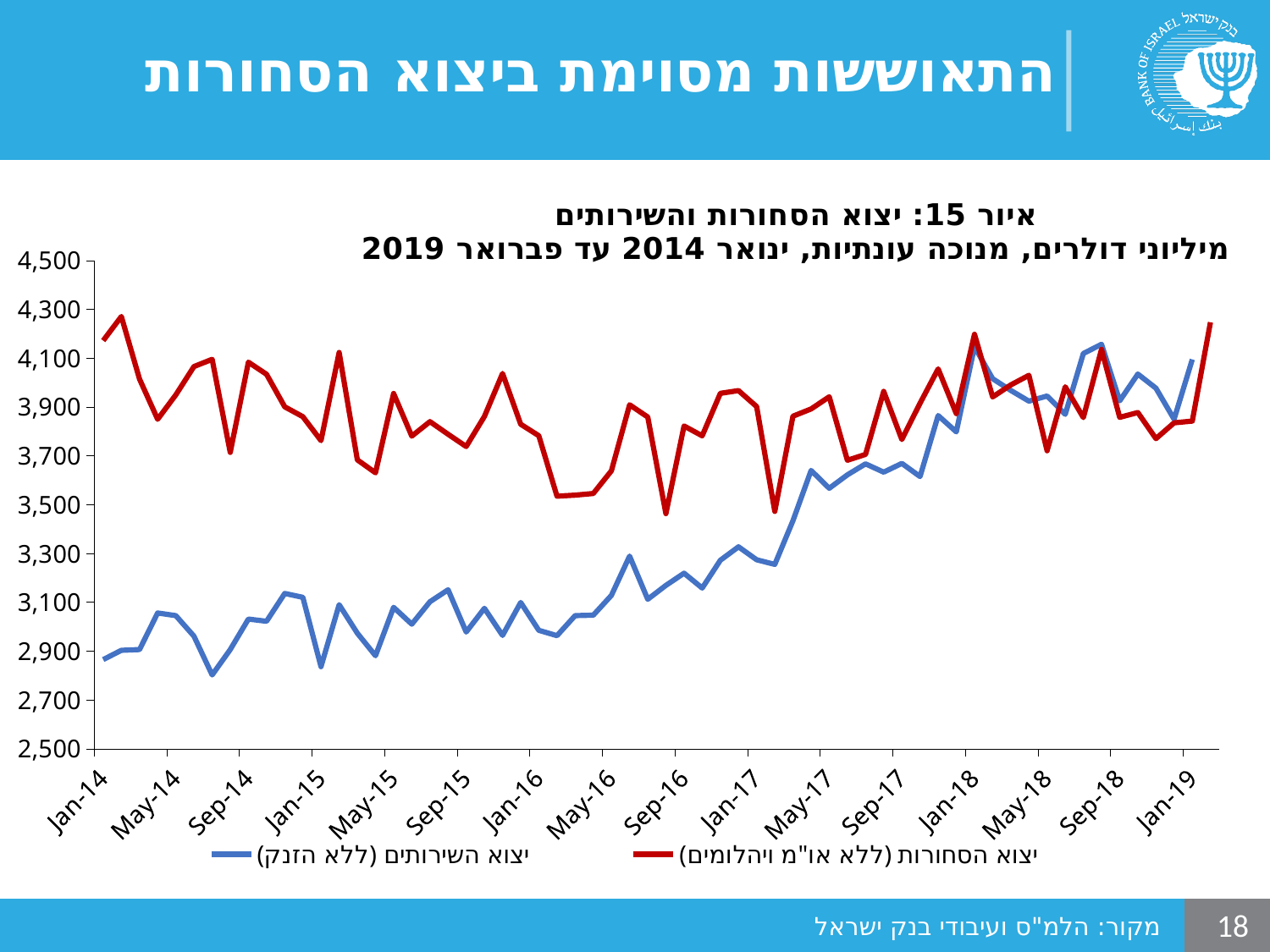
What kind of chart is shown on the slide? line chart At Jan-17, which series has the larger value: goods exports (red) or services exports (blue)? goods exports (red) Is the value of the goods exports series (red line) at Jan-16 greater or less than 3,900? less Is the value of the goods exports series (red line) at Jan-14 greater or less than 3,900? greater What is the figure number and title of the chart? איור 15: יצוא הסחורות והשירותים Which colour is used for the services exports series (יצוא השירותים (ללא הזנק))? blue Is the value of the services exports series (blue line) at Jan-14 greater or less than 3,100? less At Jan-14, which series has the larger value: goods exports (red) or services exports (blue)? goods exports (red) Does the services exports series (blue line) rise or fall overall from Jan-14 to Jan-19? rise How many series does the legend list? 2